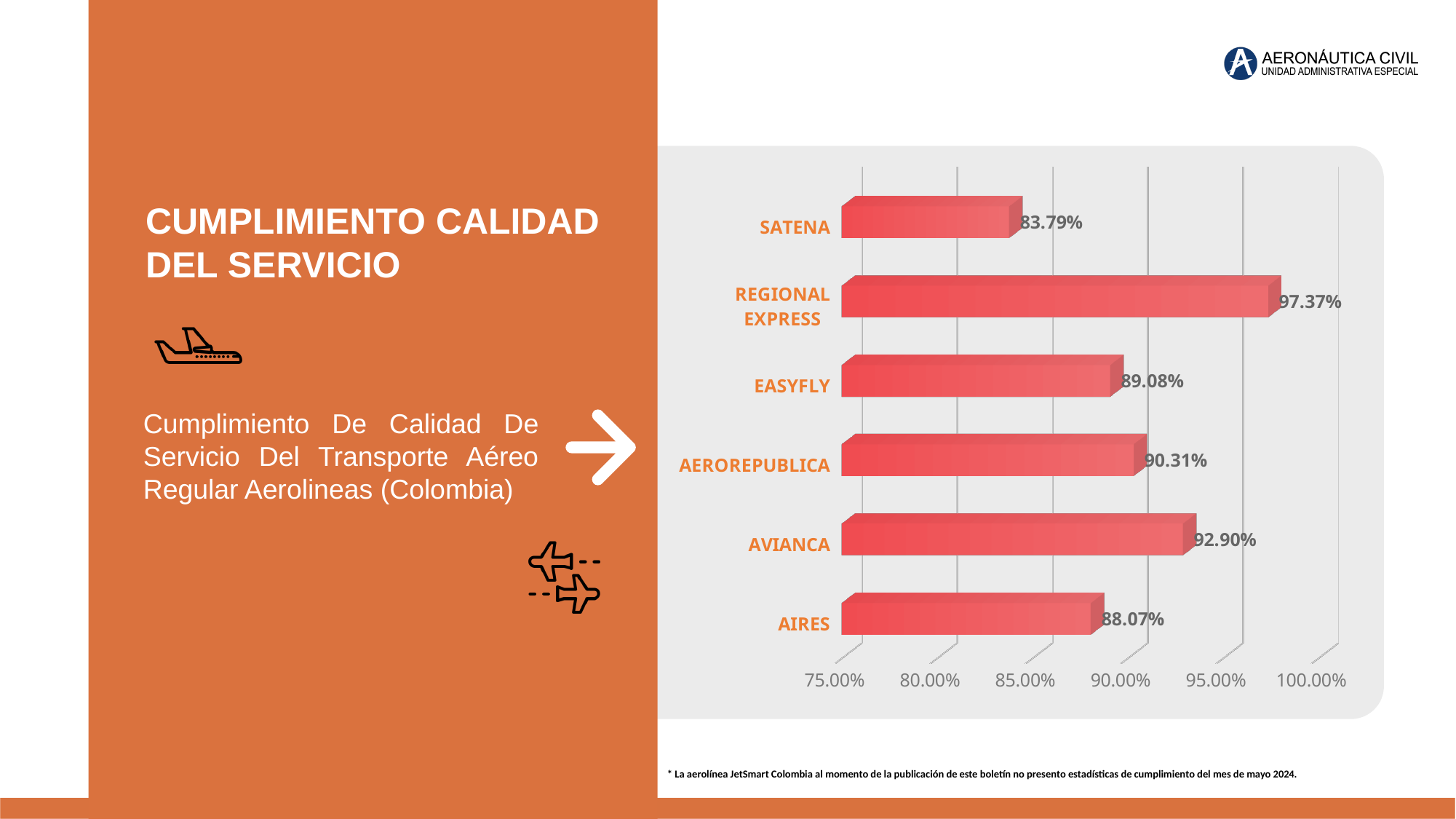
Which airline has the highest value? REGIONAL EXPRESS What is the value for EASYFLY? 89.08% Which airline has the lowest value? SATENA What is the value for AIRES? 88.07% What kind of chart is shown on the slide? Bar chart What is the value for AEROREPUBLICA? 90.31% What is the difference between the values for REGIONAL EXPRESS and SATENA? 13.58% Which is larger, the value for AVIANCA or the value for AEROREPUBLICA? AVIANCA What is the value for SATENA? 83.79% What is the value for AVIANCA? 92.90% What is the value for REGIONAL EXPRESS? 97.37% How many airlines are shown in the chart? 6